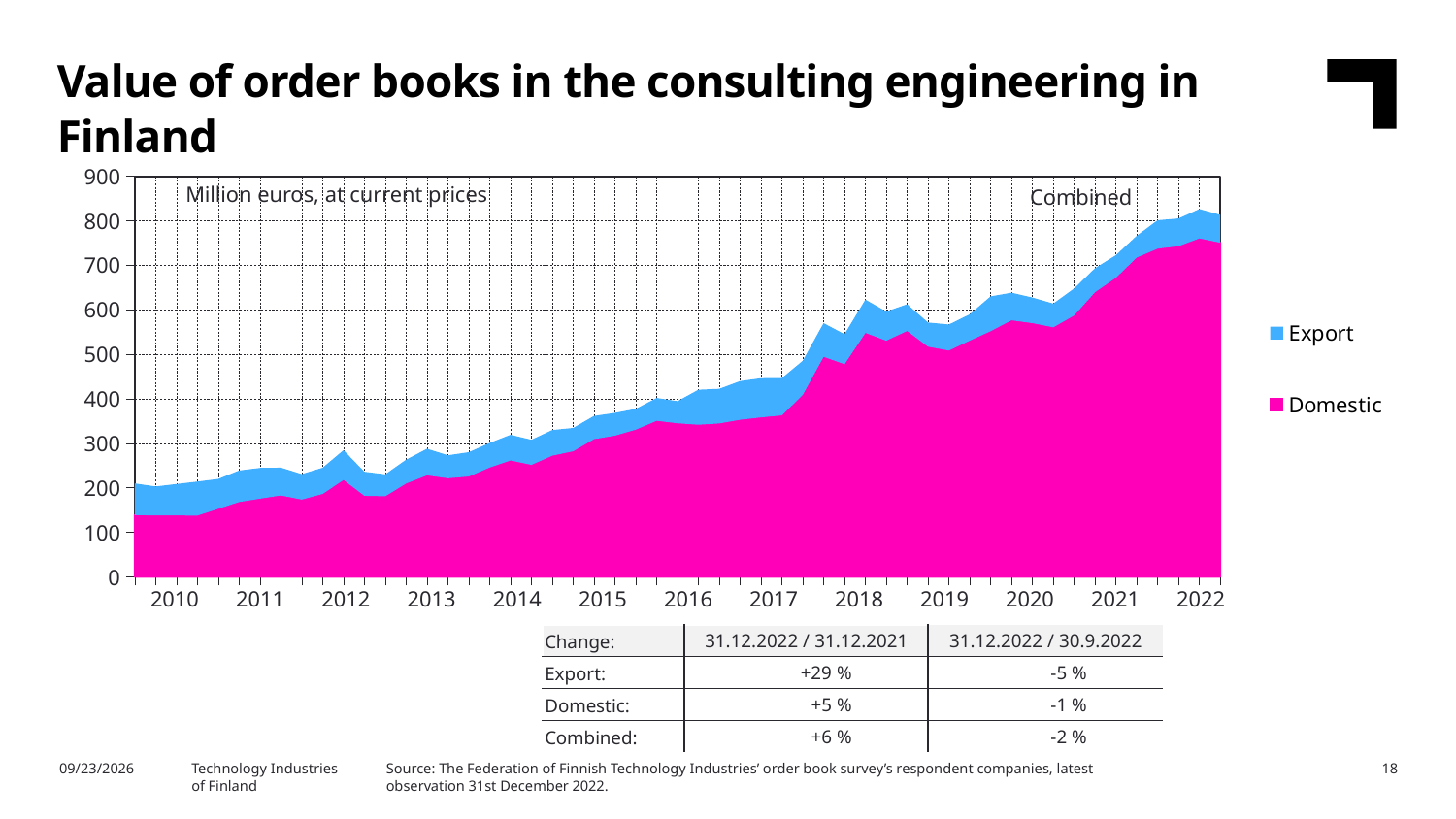
What kind of chart is shown on the slide? Stacked area chart Which is larger, the combined value in 2022 or in 2010? 2022 Is the combined value in 2018 greater or less than 500? greater Does the combined value of order books generally rise or fall from 2010 to 2022? Rise How many series does the legend list? 2 How many year labels are shown on the x axis? 13 Is the combined value at the end of 2022 greater or less than 700? greater What are the two series named in the legend? Export and Domestic Is the Domestic value at the end of 2022 greater or less than 700? greater In what unit are the values on the chart expressed, according to the label inside the plot area? Million euros, at current prices In which year on the x axis does the combined value reach its highest level? 2022